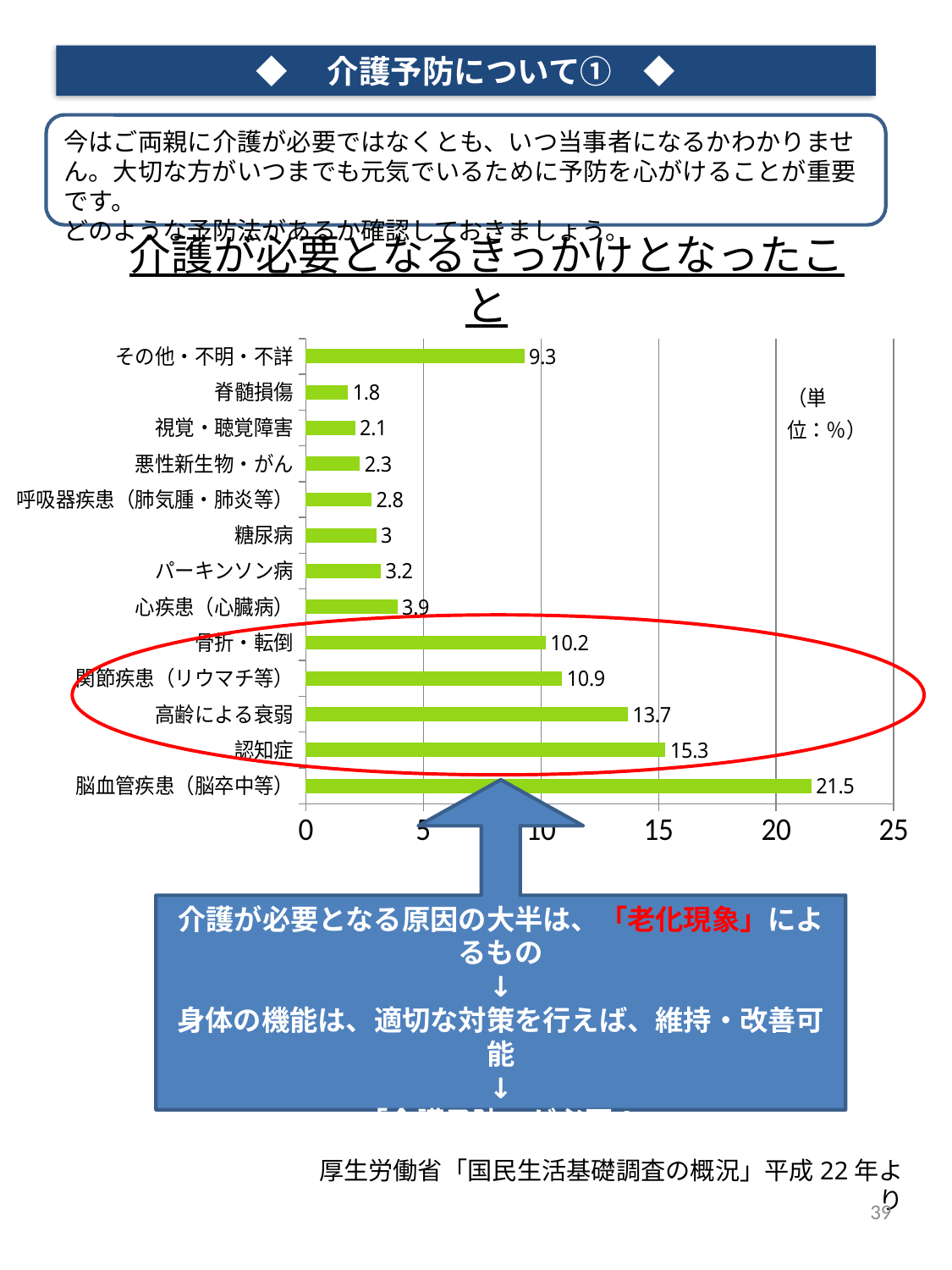
What is the difference between the values for 脳血管疾患（脳卒中等） and 認知症? 6.2 What is the value for 認知症? 15.3 Which is larger, the value for 関節疾患（リウマチ等） or the value for 骨折・転倒? 関節疾患（リウマチ等） How many categories are shown in the chart? 13 What is the value for 骨折・転倒? 10.2 Which category has the highest value? 脳血管疾患（脳卒中等） What is the value for 脳血管疾患（脳卒中等）? 21.5 Which category has the lowest value? 脊髄損傷 What kind of chart is shown on the slide? Bar chart What is the title of the chart? 介護が必要となるきっかけとなったこと What unit is indicated for the values in the chart? % What is the value for 高齢による衰弱? 13.7